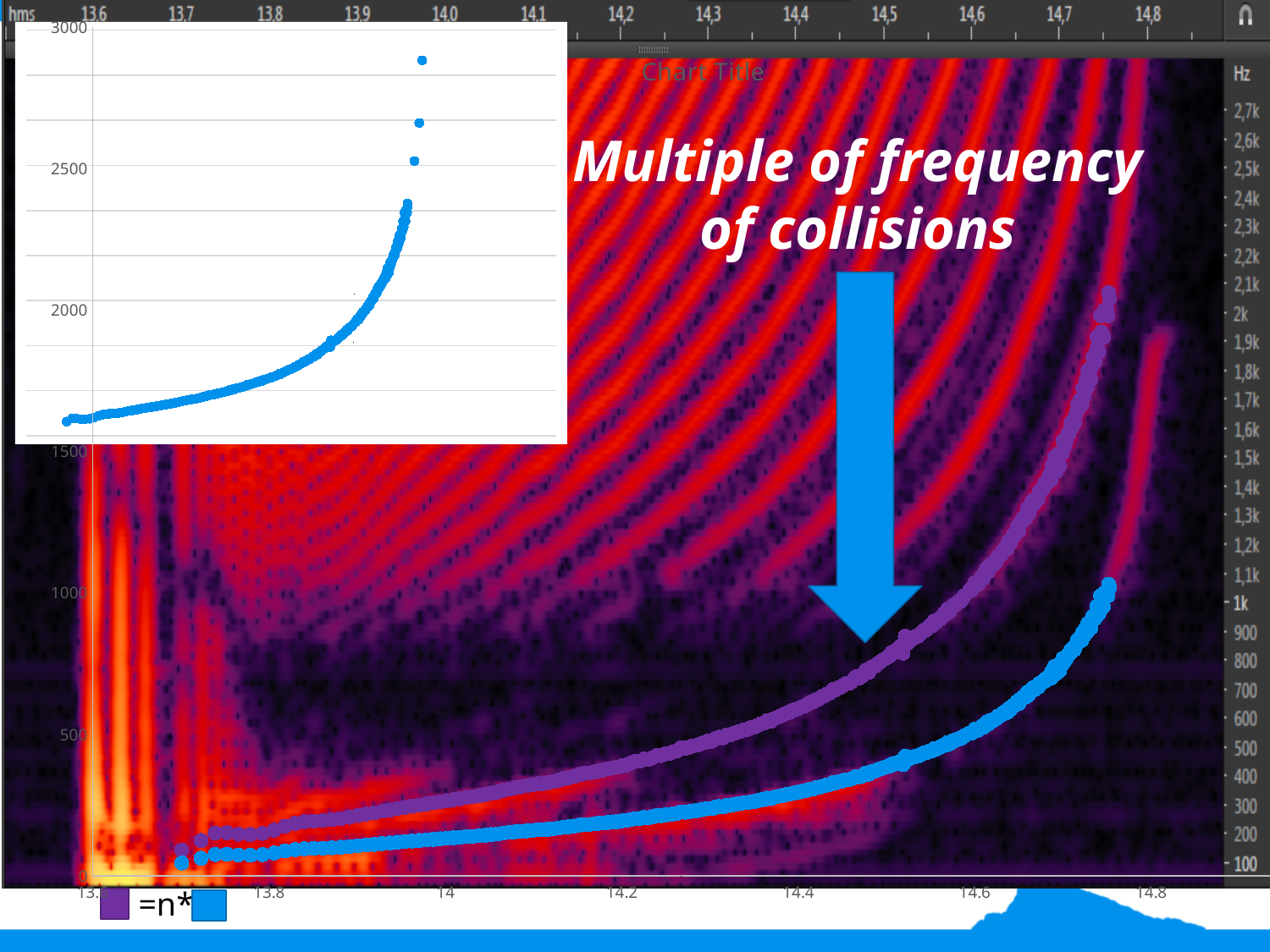
On the inset chart in the top-left corner, is the lowest plotted value greater or less than 2000? less On the large chart overlaid on the spectrogram, is the highest value of the purple series greater or less than 1500? greater On the large chart overlaid on the spectrogram, at x = 14.6, which series has the larger value, the purple series or the blue series? purple series What kind of chart is the inset chart in the top-left corner of the slide? scatter chart On the inset chart in the top-left corner, do the plotted values rise or fall from left to right? rise On the large chart overlaid on the spectrogram, do the values of the blue series rise or fall as x increases? rise On the large chart overlaid on the spectrogram, do the values of the purple series rise or fall as x increases from 13.6 to 14.8? rise What title is shown at the top of the large chart overlaid on the spectrogram? Chart Title On the inset chart in the top-left corner, is the highest plotted value greater or less than 2500? greater How many data series are plotted on the large chart overlaid on the spectrogram? 2 What kind of chart is the large chart overlaid on the spectrogram? scatter chart